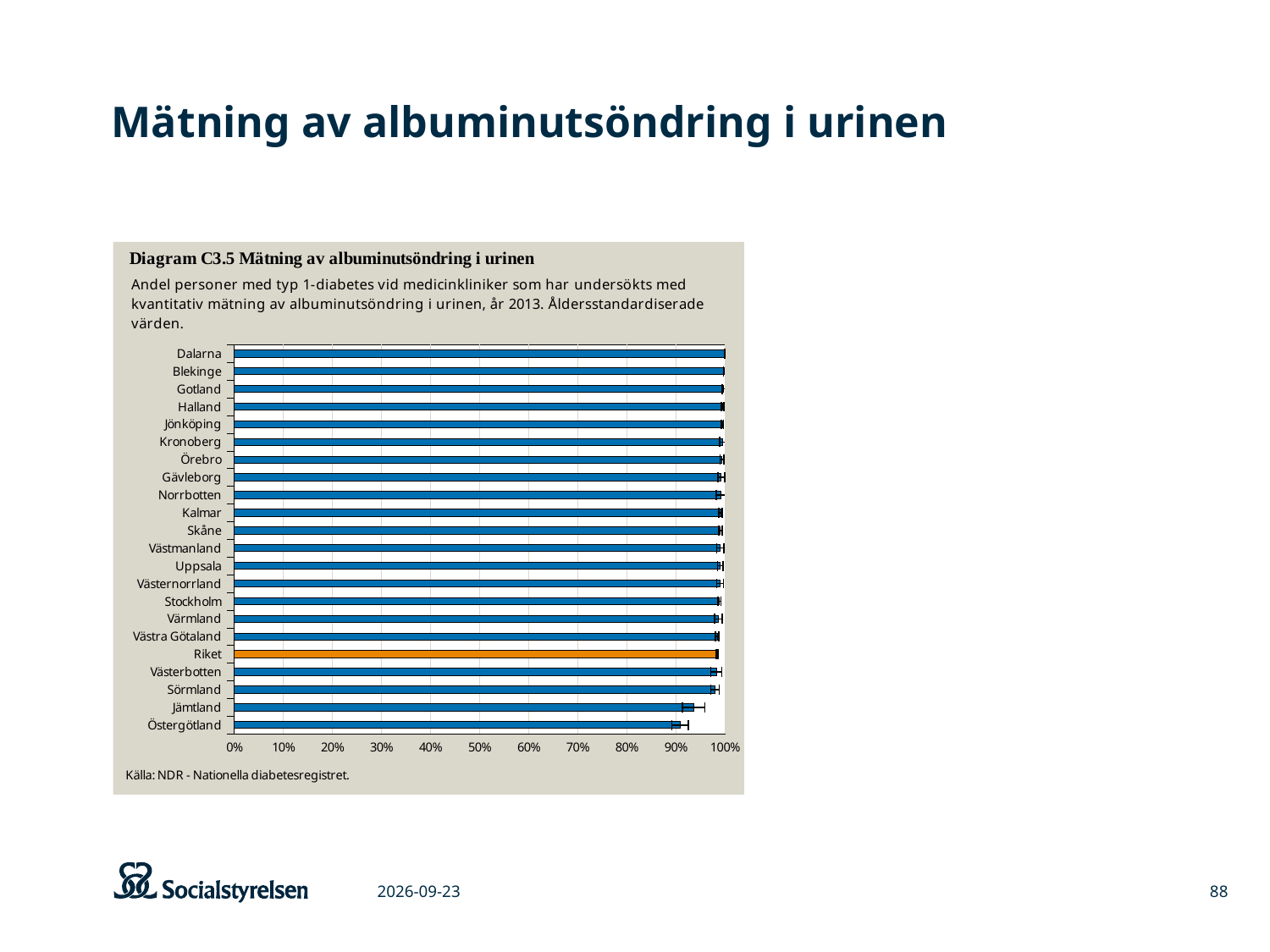
Which category has the lowest value in the chart? Östergötland Is the value for Östergötland greater or less than 95%? less Is the value for Dalarna greater or less than 90%? greater Which category is shown with an orange bar instead of a blue one? Riket Is the value for Östergötland greater or less than 80%? greater What kind of chart is shown on the slide? bar chart Which has a larger value, Jämtland or Östergötland? Jämtland What is the source cited below the chart? NDR - Nationella diabetesregistret How many categories (bars) are shown in the chart? 22 Which has a larger value, Dalarna or Östergötland? Dalarna